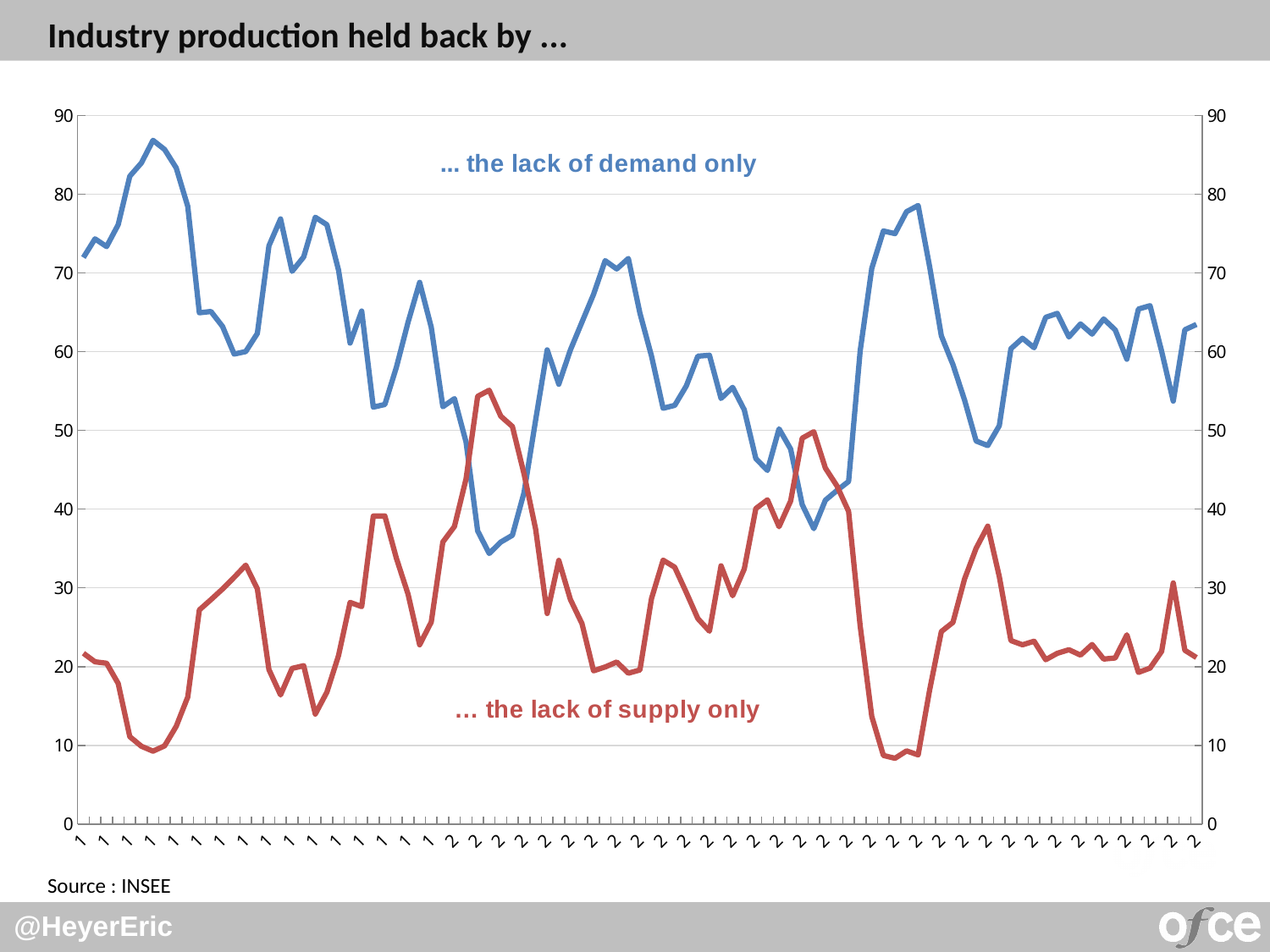
Which series reaches the lowest value on the chart? ... the lack of supply only What colour is the line for '... the lack of demand only'? blue What source is cited below the chart? INSEE Is the highest value reached by the '... the lack of supply only' line greater or less than 50? greater Which series reaches the higher peak value on the chart? ... the lack of demand only Is the lowest value reached by the '... the lack of supply only' line greater or less than 20? less At the left-hand start of the chart, which line is higher: '... the lack of demand only' or '... the lack of supply only'? ... the lack of demand only What kind of chart is shown on the slide? line chart Is the lowest value reached by the '... the lack of demand only' line greater or less than 30? greater At the right-hand end of the chart, which line is higher: '... the lack of demand only' or '... the lack of supply only'? ... the lack of demand only How many data series are plotted on the chart? 2